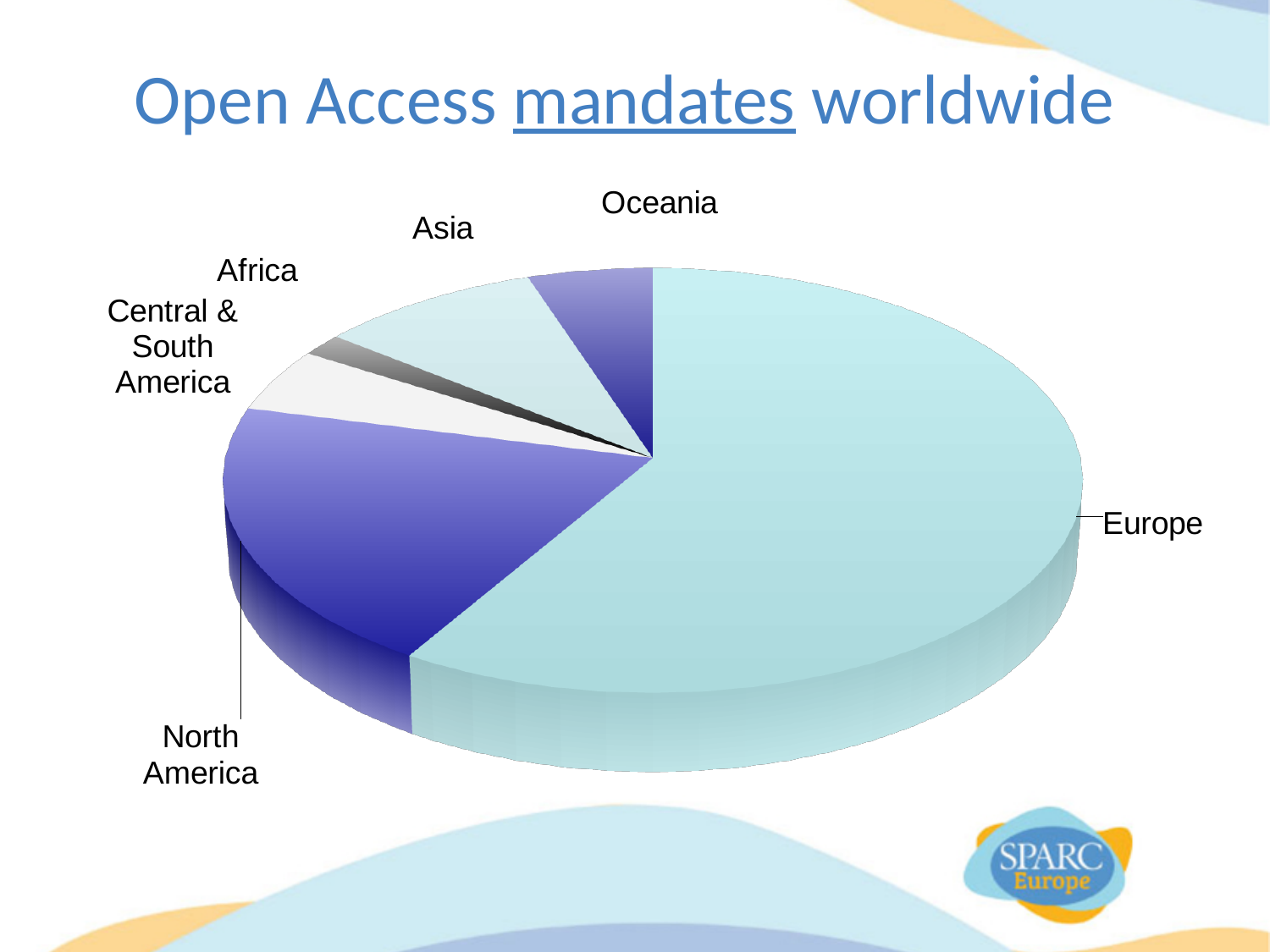
Which region has the second-largest slice of the pie chart? North America What kind of chart is shown on the slide? pie chart Which slice is larger, Asia or Africa? Asia Which slice is larger, Central & South America or Africa? Central & South America Which region has the smallest slice of the pie chart? Africa Which slice is larger, North America or Central & South America? North America Which region has the largest slice of the pie chart? Europe How many regions (slices) does the pie chart show? 6 What is the title of the slide containing the pie chart? Open Access mandates worldwide Does the Europe slice account for more or less than half of the pie? more